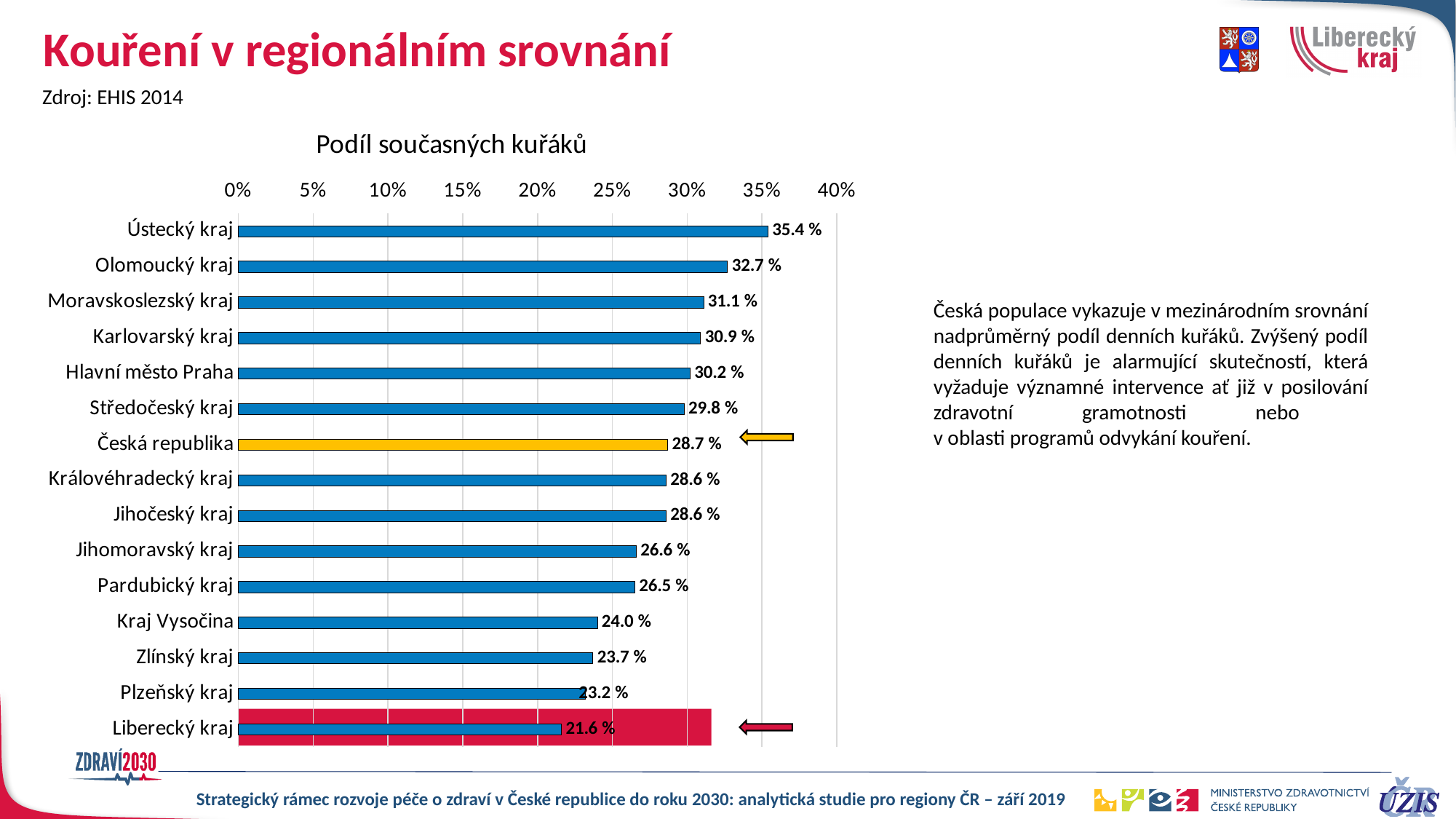
Which is larger, the value for Olomoucký kraj or the value for Moravskoslezský kraj? Olomoucký kraj Is the value for Kraj Vysočina greater or less than 25%? less What is the value for Liberecký kraj? 21.6 % What is the difference between the values for Ústecký kraj and Liberecký kraj? 13.8 % Which category has the highest value? Ústecký kraj How many bars are shown in the chart? 15 What is the value for Česká republika? 28.7 % Which category has the lowest value? Liberecký kraj What kind of chart is shown on the slide? bar chart What is the value for Hlavní město Praha? 30.2 % What is the title of the chart? Podíl současných kuřáků What is the value for Ústecký kraj? 35.4 %